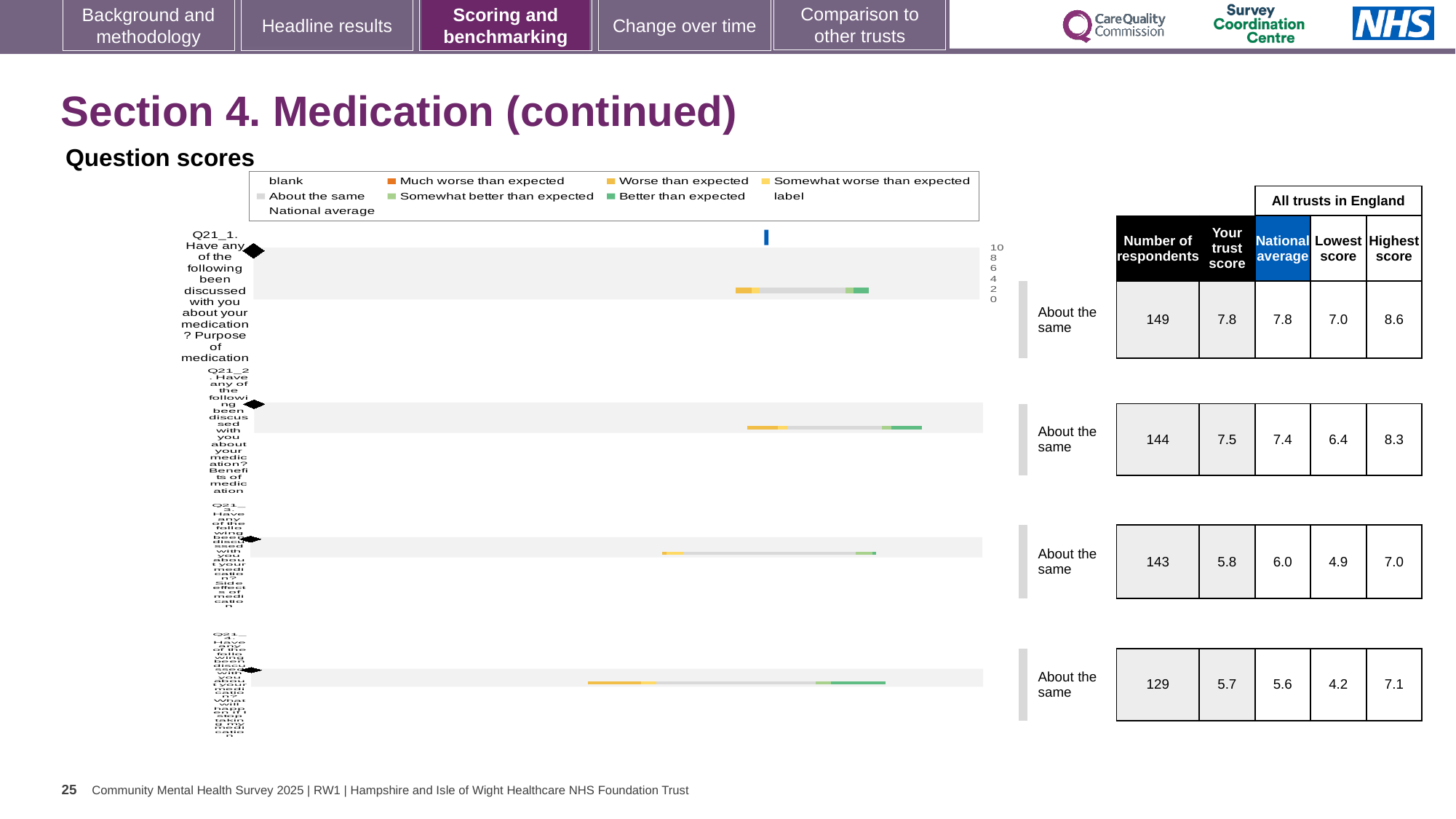
Which question has the highest number of respondents? Q21_1 What is the highest value shown on the chart's score axis? 10 Which question has the lowest trust score? Q21_4 What is the number of respondents for Q21_1 (Purpose of medication)? 149 Which legend entry is shown in dark orange in the question scores chart? Much worse than expected Which has the larger trust score, Q21_1 or Q21_3? Q21_1 What kind of chart is used to show the question scores on this slide? bar chart What is the national average for Q21_3, the third question row? 6.0 What is the trust score for Q21_2 (Benefits of medication)? 7.5 What is the highest score across all trusts in England for Q21_4, the fourth question row? 7.1 How many questions (bars) are plotted in the question scores chart? 4 What is the difference in number of respondents between Q21_1 and Q21_4? 20